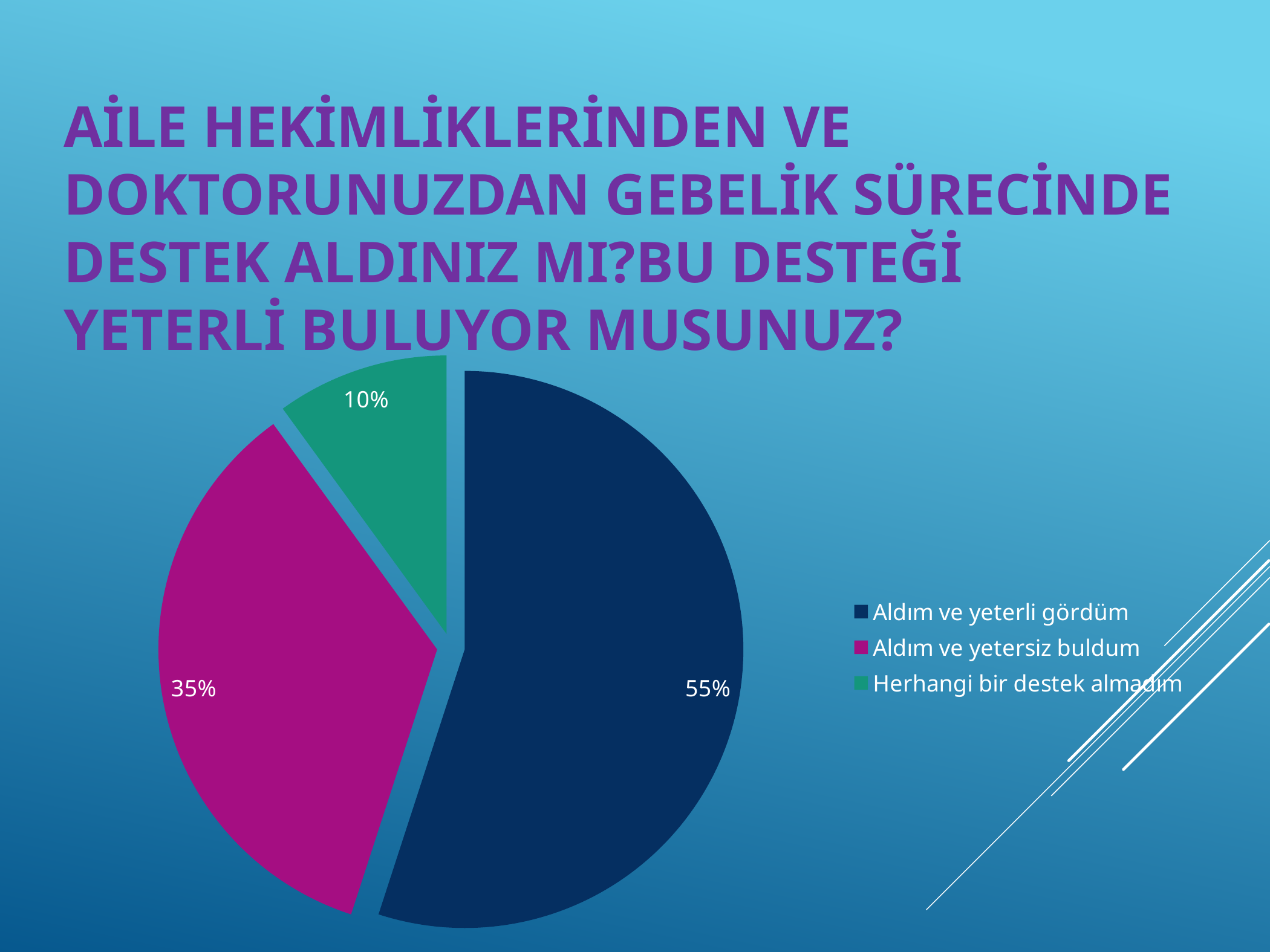
What is the difference in percentage points between "Aldım ve yeterli gördüm" and "Aldım ve yetersiz buldum"? 20 What share of the pie is labelled "Aldım ve yeterli gördüm"? 55% What share of the pie is labelled "Herhangi bir destek almadım"? 10% What is the difference in percentage points between "Aldım ve yetersiz buldum" and "Herhangi bir destek almadım"? 25 Which is larger: the slice for "Aldım ve yetersiz buldum" or the slice for "Herhangi bir destek almadım"? Aldım ve yetersiz buldum What kind of chart is shown on the slide? pie chart What colour is the slice for "Herhangi bir destek almadım"? green How many entries does the legend list? 3 Which category has the largest slice of the pie? Aldım ve yeterli gördüm Which category has the smallest slice of the pie? Herhangi bir destek almadım How many slices does the pie chart have? 3 What share of the pie is labelled "Aldım ve yetersiz buldum"? 35%